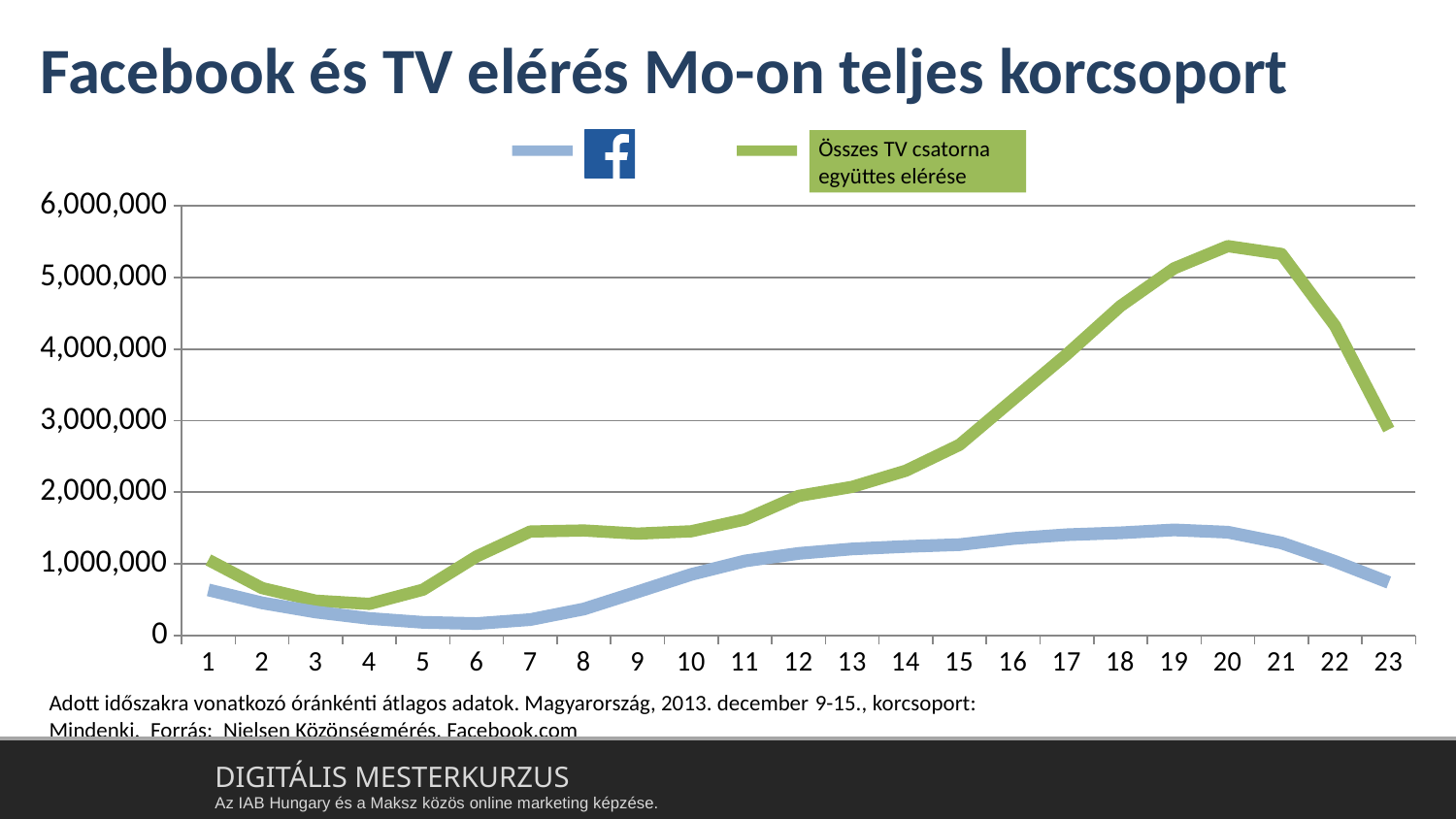
At x-axis value 20, which series has the larger value, Facebook or 'Összes TV csatorna együttes elérése'? Összes TV csatorna együttes elérése Is the value of the Facebook series at 23 greater or less than 1,000,000? less At which x-axis value is the 'Összes TV csatorna együttes elérése' series at its lowest? 4 What kind of chart is shown on the slide? line chart At which x-axis value does the 'Összes TV csatorna együttes elérése' series reach its highest point? 20 How many series does the legend list? 2 Is the value of the 'Összes TV csatorna együttes elérése' series at 20 greater or less than 5,000,000? greater How many points are plotted along the x axis for each series? 23 Is the value of the 'Összes TV csatorna együttes elérése' series at 18 greater or less than 4,000,000? greater What is the legend label of the green series? Összes TV csatorna együttes elérése Does the 'Összes TV csatorna együttes elérése' series rise or fall between 20 and 23 on the x axis? fall